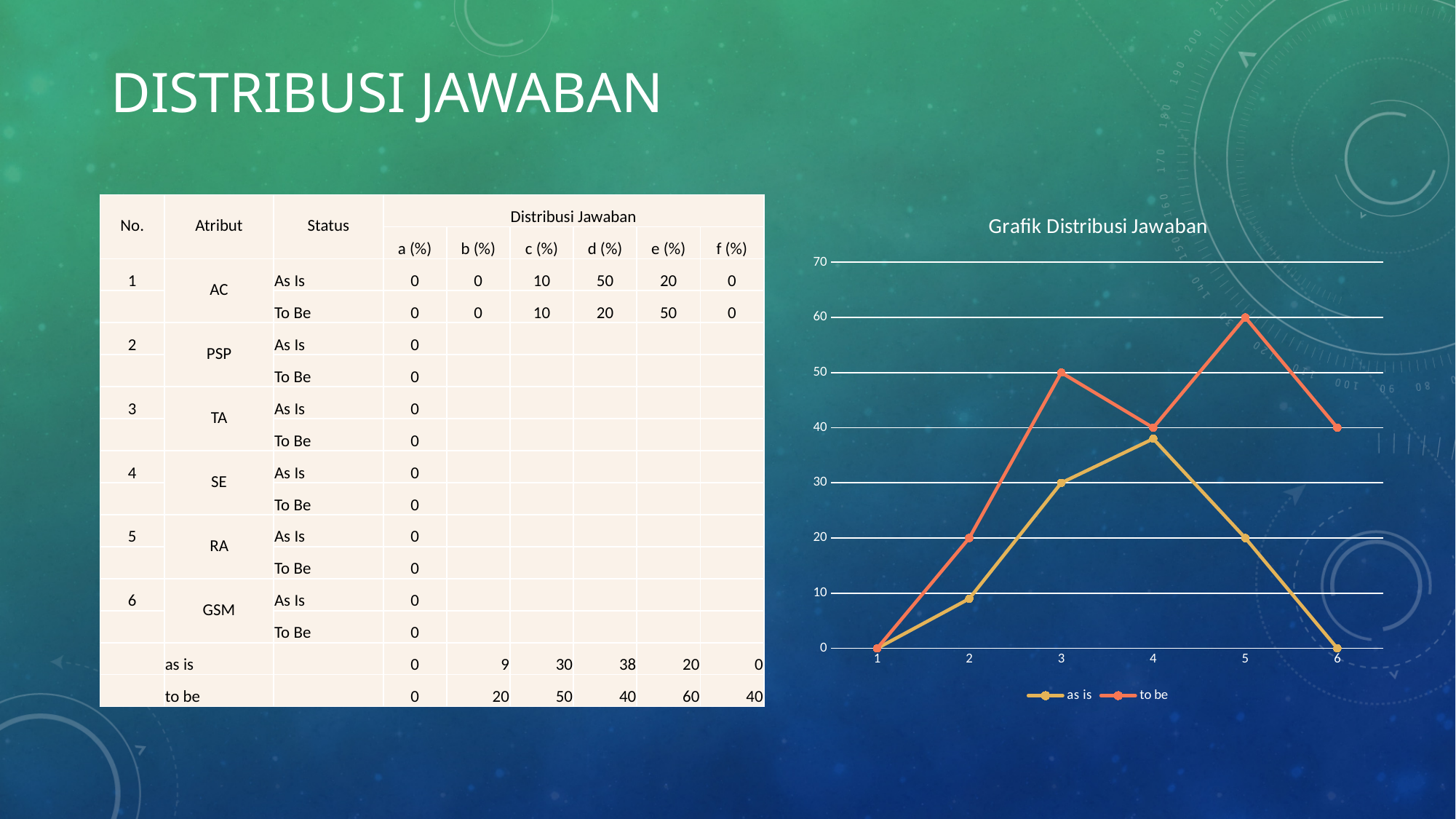
At which x value does the "to be" series reach its highest point? 5 What kind of chart is shown on the slide? line chart At which x value does the "as is" series reach its highest point? 4 What is the value of the "to be" series at x = 5? 60 How many series does the chart's legend list? 2 Which series is higher at x = 6, "as is" or "to be"? to be How many points are plotted along the x axis for each series in the chart? 6 What is the title of the chart on the slide? Grafik Distribusi Jawaban What is the value of the "to be" series at x = 3? 50 Is the value of the "as is" series at x = 2 greater or less than 10? less What is the value of the "as is" series at x = 3? 30 What is the difference between the "to be" and "as is" values at x = 5? 40